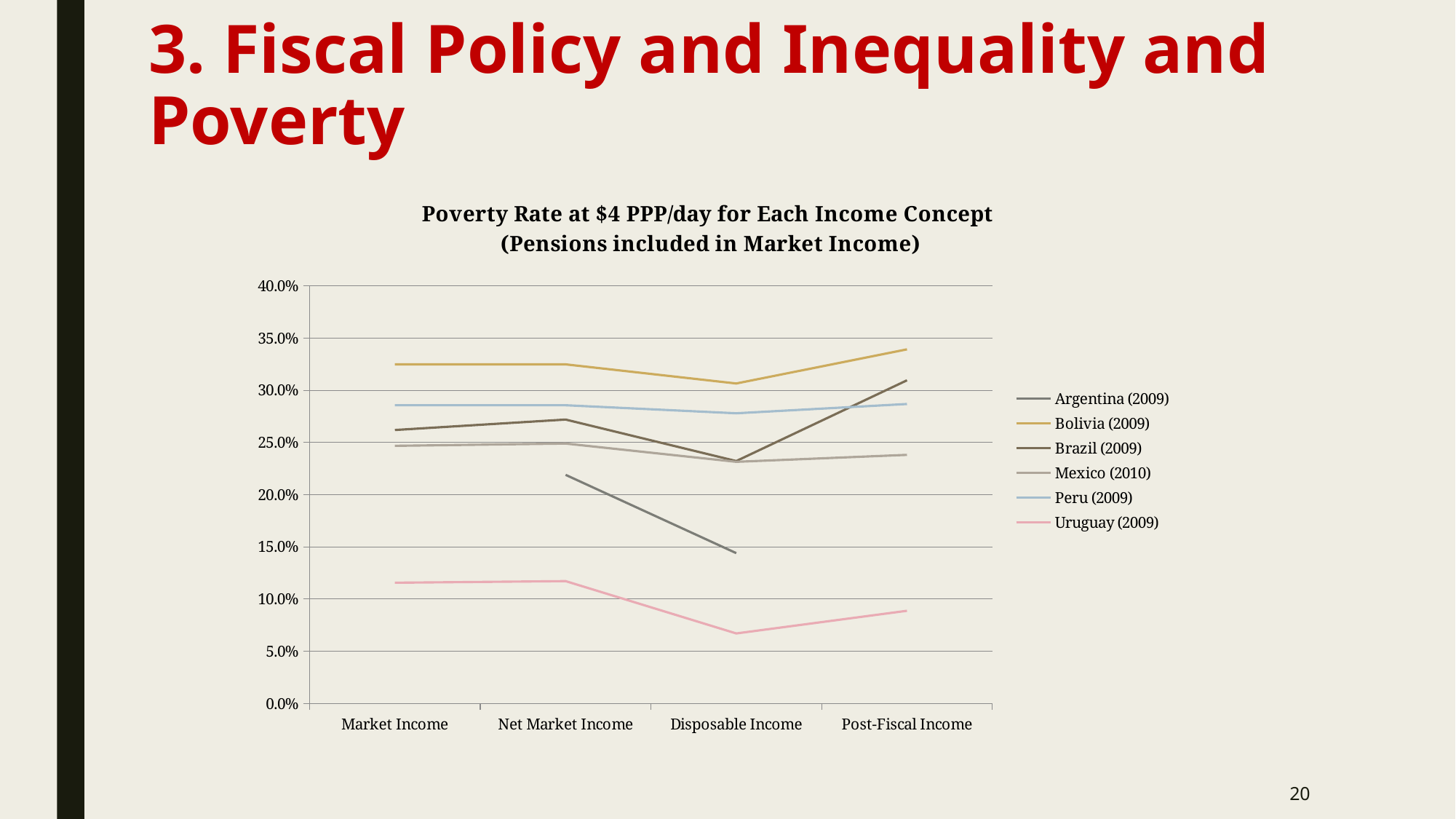
Which country has the highest poverty rate at Market Income? Bolivia (2009) How many income concepts are shown along the x axis? 4 Is the value for Argentina (2009) at Net Market Income greater or less than 20.0%? greater Which country has the lowest poverty rate at Disposable Income? Uruguay (2009) At Market Income, which is larger: the value for Peru (2009) or Brazil (2009)? Peru (2009) What kind of chart is shown on the slide? line chart Is the value for Uruguay (2009) at Disposable Income greater or less than 10.0%? less Is the value for Bolivia (2009) at Post-Fiscal Income greater or less than 30.0%? greater Does the Uruguay (2009) line rise or fall from Net Market Income to Disposable Income? fall Which country has the highest poverty rate at Post-Fiscal Income? Bolivia (2009) How many series does the legend list? 6 At Post-Fiscal Income, which is larger: the value for Brazil (2009) or Peru (2009)? Brazil (2009)